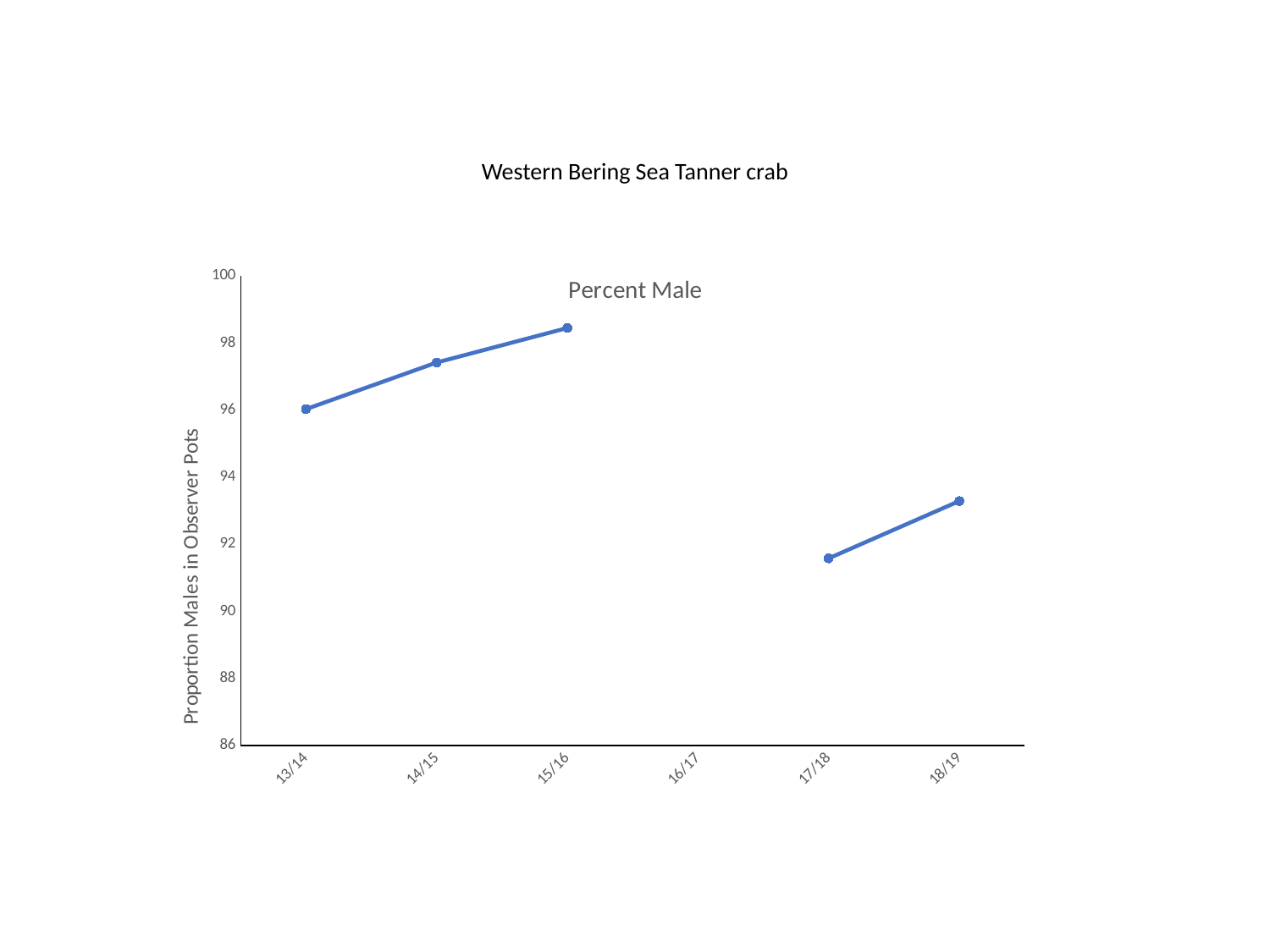
Do the values rise or fall from 13/14 to 15/16? rise Is the value for 18/19 greater or less than 92? greater Which season has the highest percent male value? 15/16 What is the label on the vertical axis of the chart? Proportion Males in Observer Pots What is the title of the chart? Percent Male How many data points are plotted on the line in the chart? 5 Which season has the larger percent male value, 13/14 or 18/19? 13/14 How many season labels are shown on the x axis of the chart? 6 What kind of chart is shown on the slide? line chart Which season has the lowest percent male value? 17/18 Is the value for 17/18 greater or less than 94? less Is the value for 13/14 greater or less than 94? greater